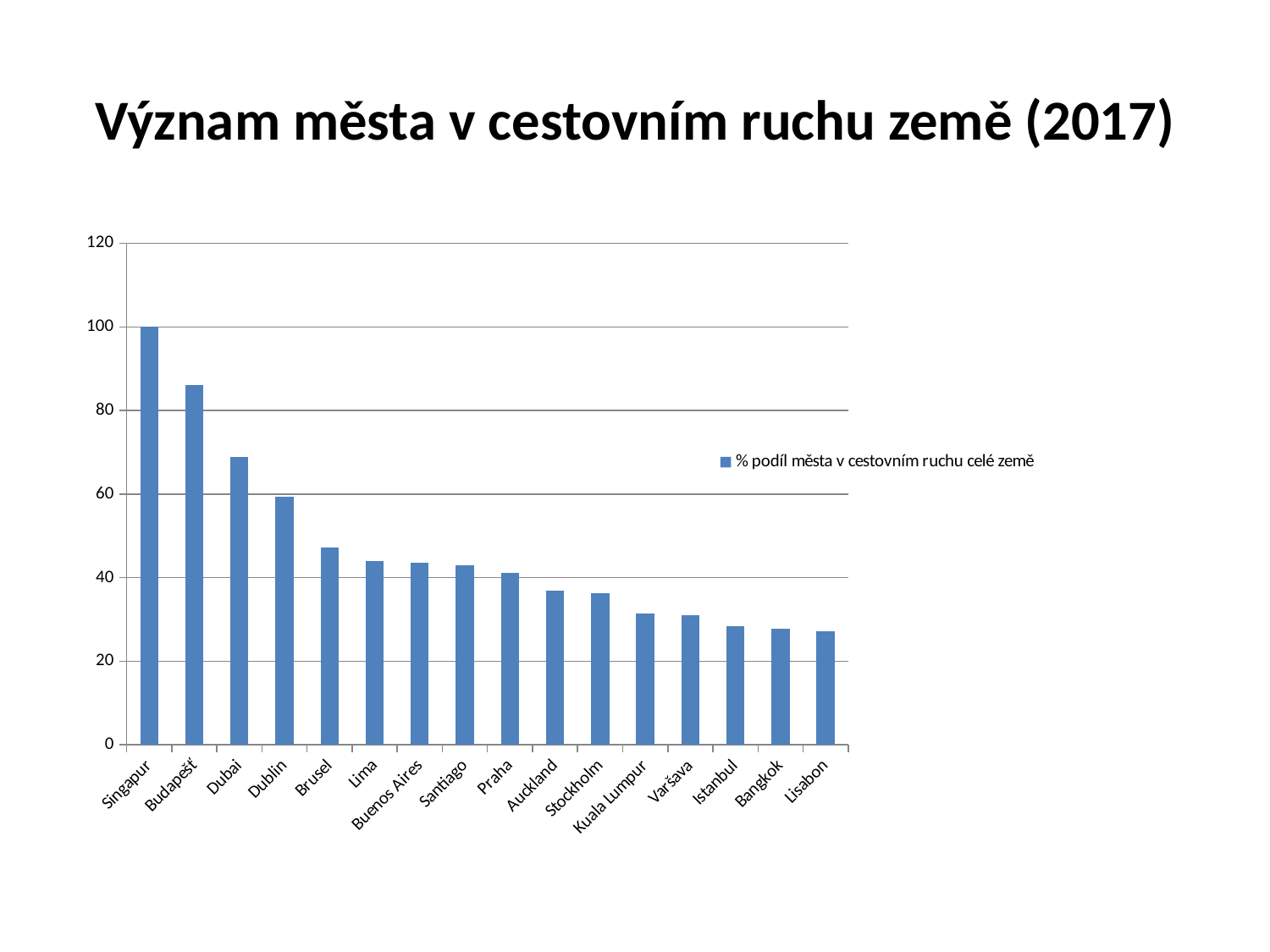
What kind of chart is shown on the slide? bar chart How many cities are shown on the x axis of the chart? 16 Is the value for Budapešť greater or less than 80? greater Is the value for Lisabon greater or less than 40? less Is the value for Auckland greater or less than 40? less Do the values rise or fall from left to right along the x axis? fall What is the value for Singapur? 100 Which city has the highest value in the chart? Singapur Which has the larger value, Dubai or Dublin? Dubai What is the title of the slide? Význam města v cestovním ruchu země (2017) How many series does the chart's legend list? 1